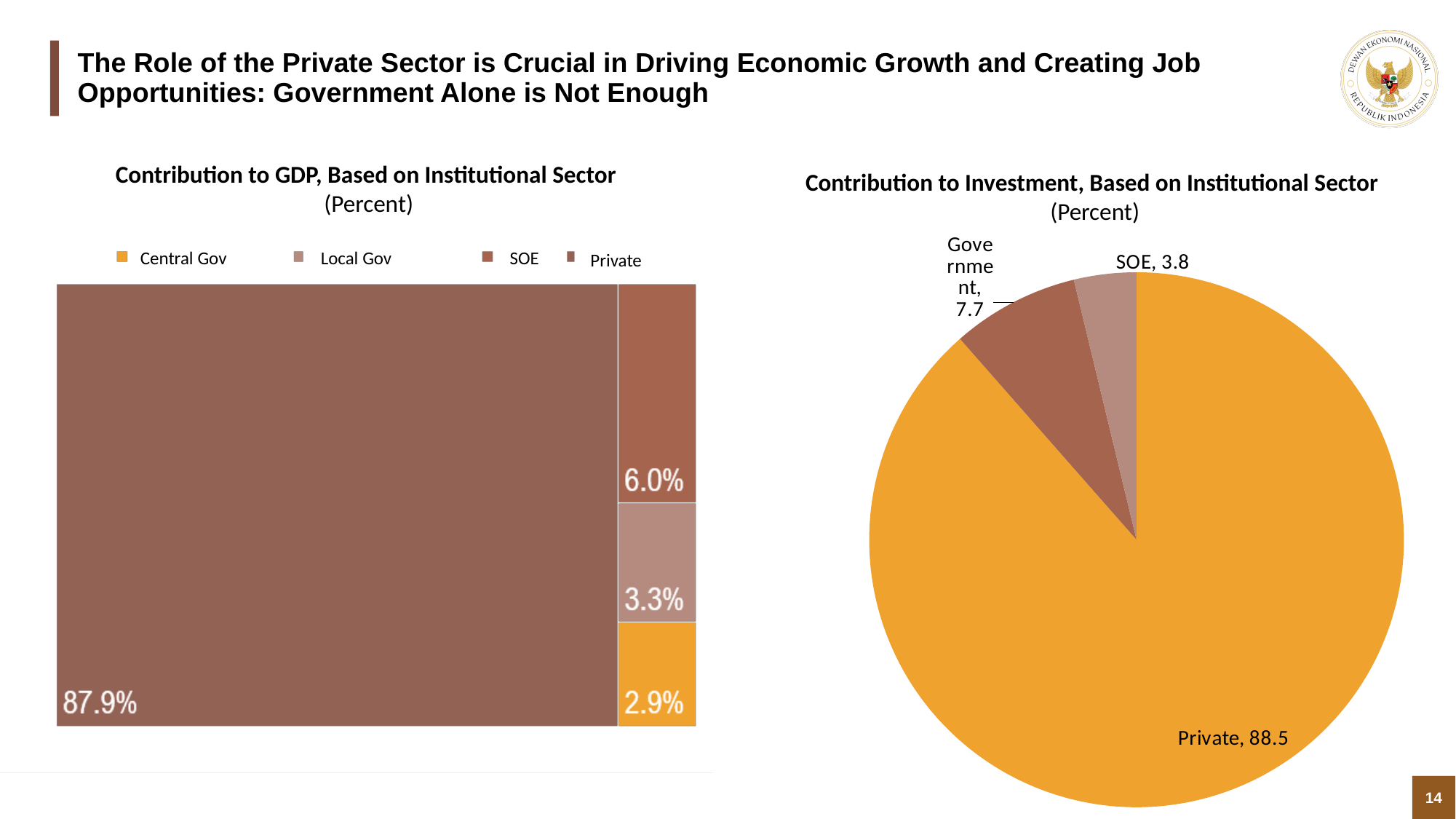
What kind of chart is the 'Contribution to Investment, Based on Institutional Sector' chart? Pie chart In the 'Contribution to GDP, Based on Institutional Sector' chart, which sector has the lowest contribution? Central Gov In the 'Contribution to Investment, Based on Institutional Sector' chart, what is the value for Private? 88.5 In the 'Contribution to Investment, Based on Institutional Sector' chart, how many slices does the pie have? 3 In the 'Contribution to Investment, Based on Institutional Sector' chart, which is larger, Government or SOE? Government In the 'Contribution to GDP, Based on Institutional Sector' chart, what is the difference between the SOE value and the Local Gov value? 2.7% In the 'Contribution to GDP, Based on Institutional Sector' chart, what is the value for Local Gov? 3.3% In the 'Contribution to GDP, Based on Institutional Sector' chart, what is the value for Central Gov? 2.9% In the 'Contribution to Investment, Based on Institutional Sector' chart, what is the value for SOE? 3.8 In the 'Contribution to GDP, Based on Institutional Sector' chart, what is the value for Private? 87.9% In the 'Contribution to GDP, Based on Institutional Sector' chart, how many sectors does the legend list? 4 In the 'Contribution to Investment, Based on Institutional Sector' chart, what is the value for Government? 7.7